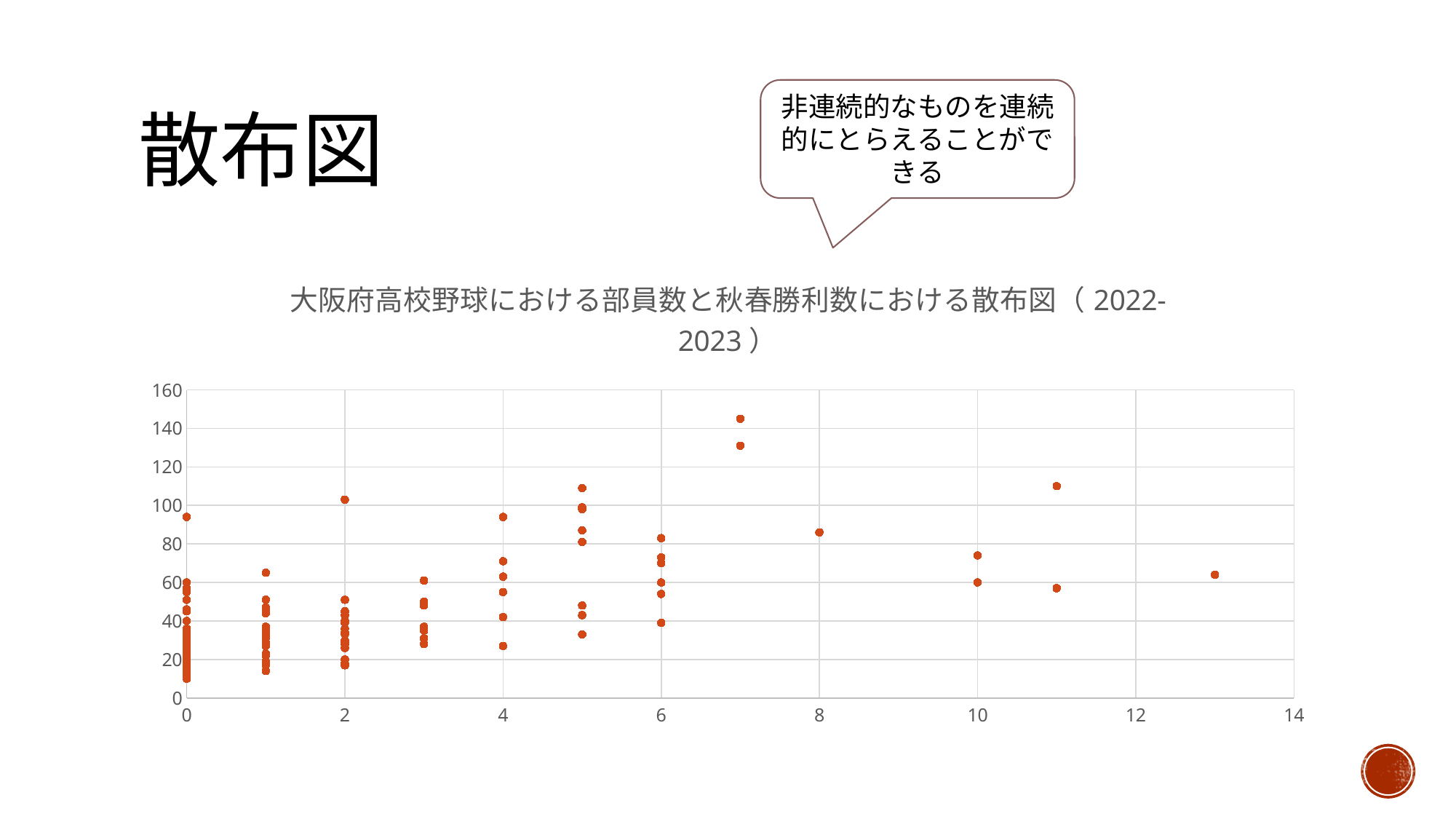
What is the title of the chart? 大阪府高校野球における部員数と秋春勝利数における散布図（2022-2023） Which has the higher y value: the point at x = 8 or the point at x = 13? the point at x = 8 What is the highest value shown on the vertical axis of the chart? 160 How many points are plotted at x = 7? 2 Is the y value of the highest point at x = 11 greater or less than 100? greater Is the y value of the higher point at x = 10 greater or less than 80? less Is the y value of the point at x = 13 greater or less than 60? greater How many points are plotted at x = 8? 1 What is the largest x-axis value at which a point is plotted? 13 What kind of chart is shown on the slide? scatter chart